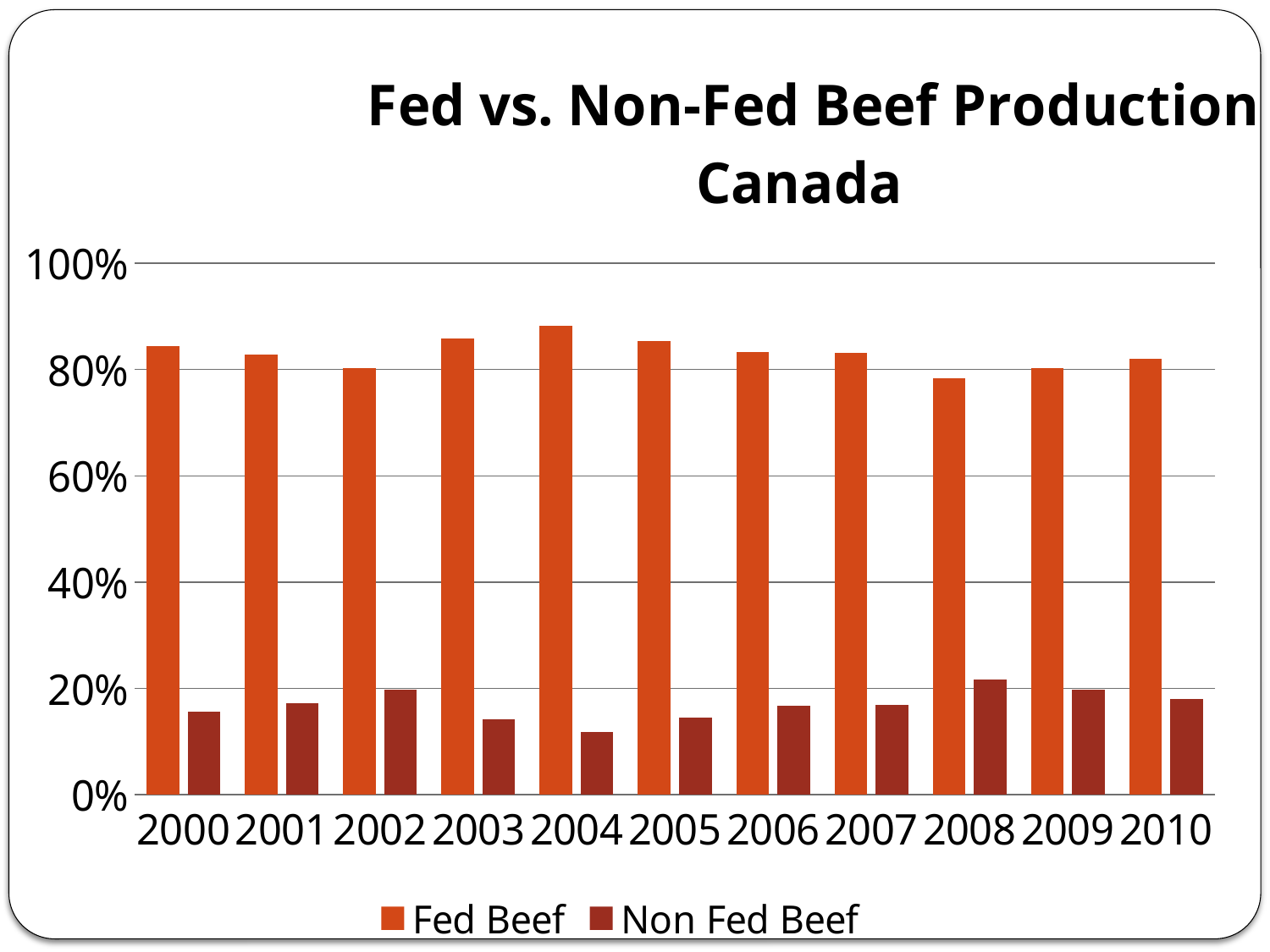
What kind of chart is shown on the slide? bar chart Is the Fed Beef value for 2000 greater or less than 80%? greater Which year has the lowest Fed Beef share? 2008 Which year has the highest Non Fed Beef share? 2008 Which is larger, the Non Fed Beef value for 2002 or for 2004? 2002 Is the Non Fed Beef value for 2004 greater or less than 20%? less How many series does the legend list? 2 How many years are shown on the x axis? 11 What is the title of the chart? Fed vs. Non-Fed Beef Production Canada Which year has the lowest Non Fed Beef share? 2004 Which year has the highest Fed Beef share? 2004 Is the Fed Beef value for 2004 greater or less than 80%? greater